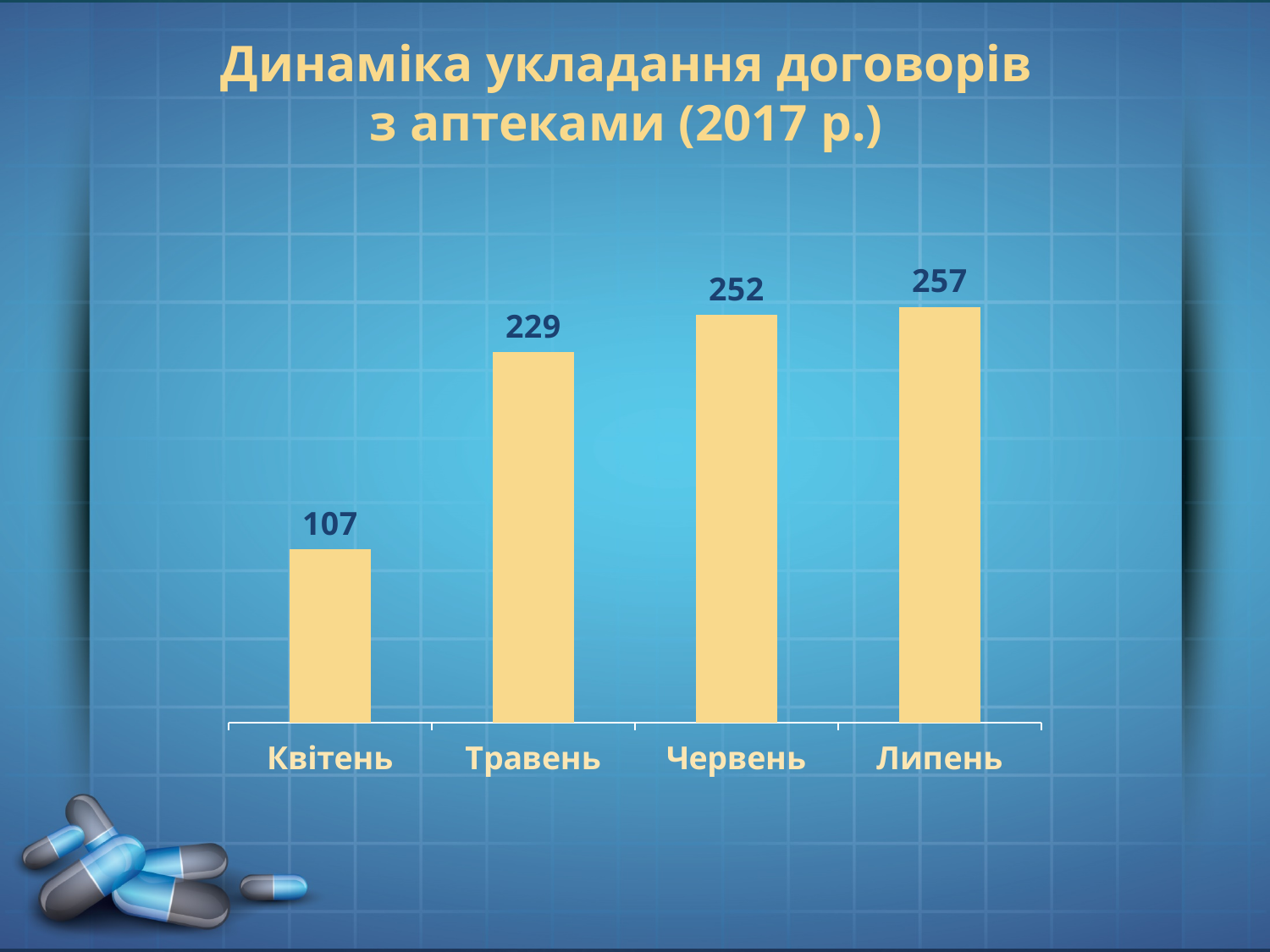
What is the value for Травень? 229 What is the value for Квітень? 107 What is the value for Червень? 252 Which month has the highest value? Липень Which month has the lowest value? Квітень What is the value for Липень? 257 What is the difference between the values for Травень and Квітень? 122 What is the difference between the values for Липень and Червень? 5 What kind of chart is shown on the slide? Bar chart Do the values rise or fall from Квітень to Липень? Rise Which is larger, the value for Травень or the value for Червень? Червень How many months are shown on the chart? 4